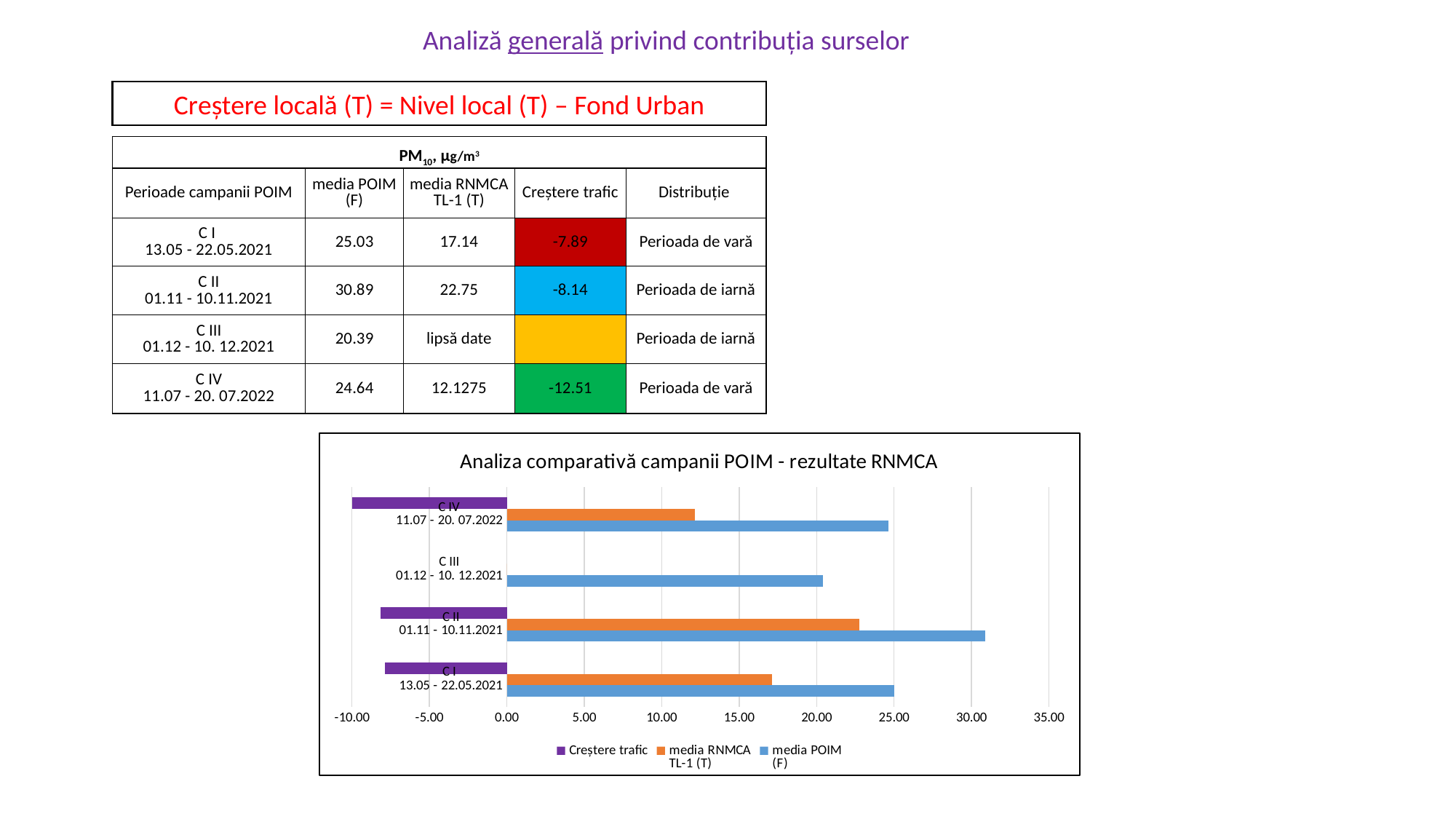
What is the title of the chart? Analiza comparativă campanii POIM - rezultate RNMCA Which campaign has the highest media POIM (F) value in the chart? C II 01.11 - 10.11.2021 What kind of chart is shown on the slide? bar chart Which is larger in the chart: the media RNMCA TL-1 (T) value for C I or for C II? C II Is the media RNMCA TL-1 (T) value for C IV greater or less than 15.00? less Is the media POIM (F) value for C II greater or less than 25.00? greater Is the media POIM (F) value for C III greater or less than 15.00? greater How many series does the chart legend list? 3 Which campaign in the chart has only a media POIM (F) bar and no media RNMCA TL-1 (T) bar? C III 01.12 - 10. 12.2021 How many campaign categories are shown on the chart's vertical axis? 4